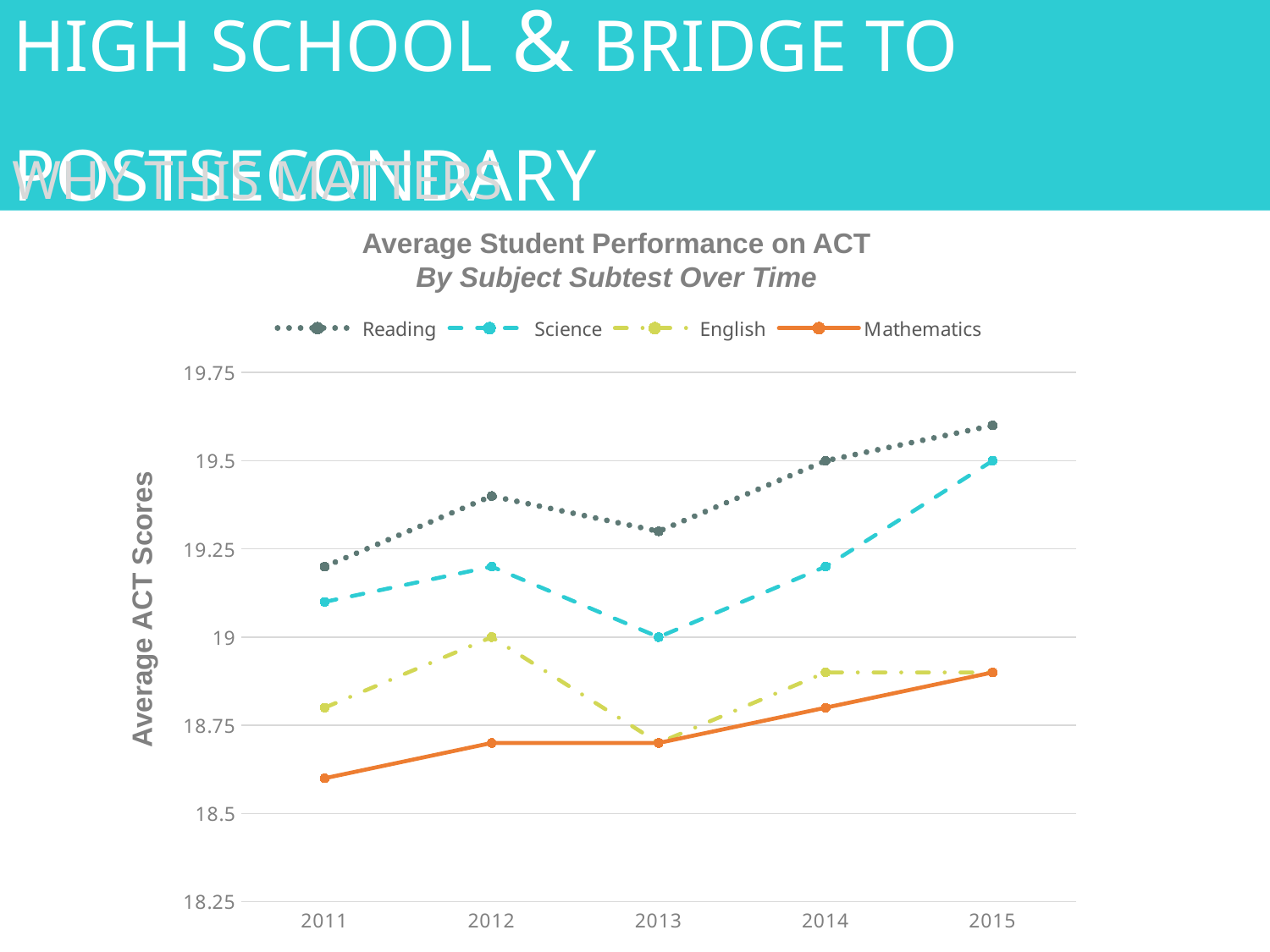
Is the Mathematics value for 2011 greater or less than 18.5? greater Which subject has the lowest average ACT score in 2011? Mathematics How many years are shown on the x axis? 5 What kind of chart is shown on the slide? Line chart In 2013, which is higher, Reading or Science? Reading How many series does the legend list? 4 What is the title of the chart? Average Student Performance on ACT By Subject Subtest Over Time Which subject has the highest average ACT score in 2015? Reading What is the Science value in 2013? 19 What is the Science value in 2015? 19.5 What is the Reading value in 2014? 19.5 Do the Mathematics values rise or fall from 2011 to 2015? rise